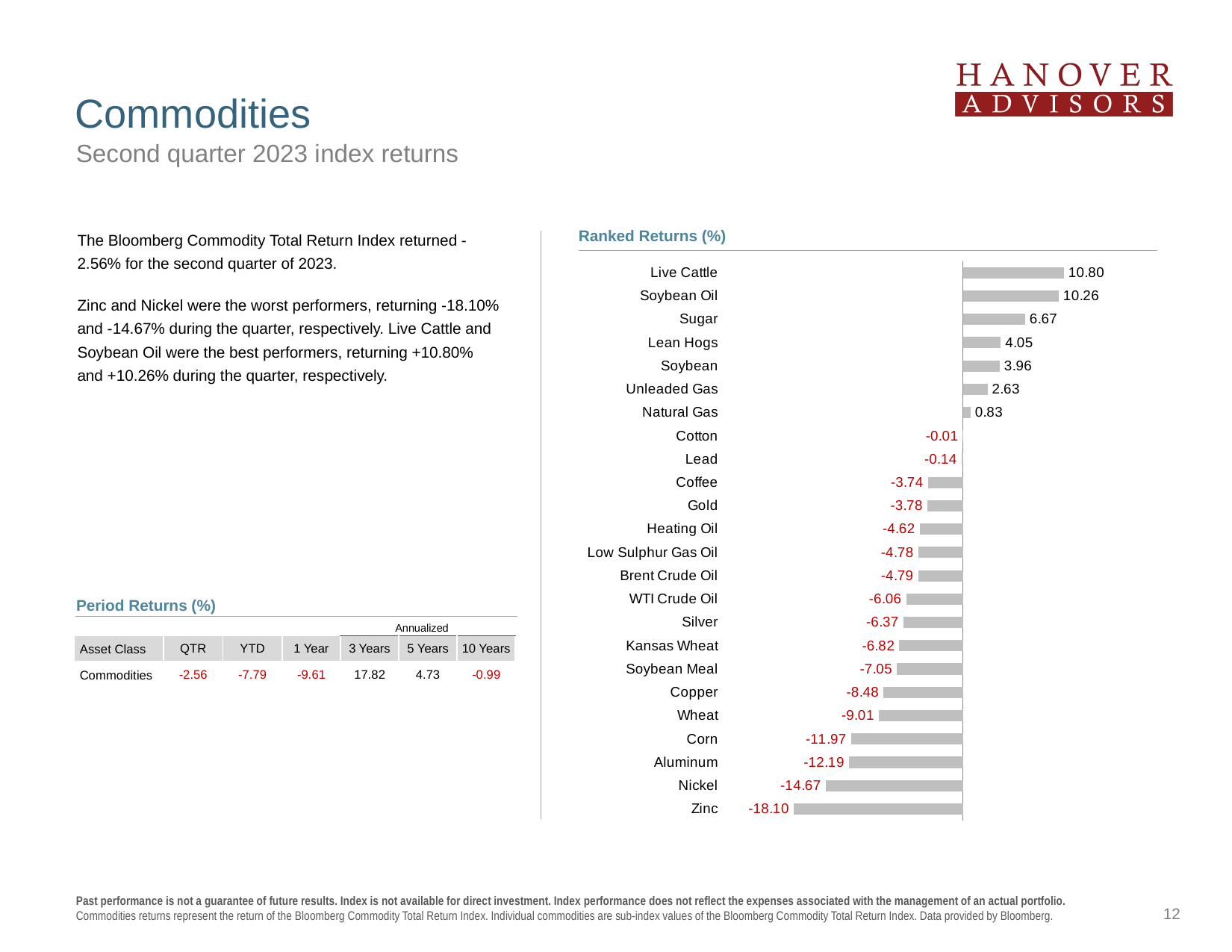
What is the value for Natural Gas in the Ranked Returns (%) chart? 0.83 What kind of chart is the Ranked Returns (%) chart? Bar chart What is the difference between the values for Live Cattle and Soybean Oil in the Ranked Returns (%) chart? 0.54 What is the value for Zinc in the Ranked Returns (%) chart? -18.10 What is the difference between the values for Nickel and Zinc in the Ranked Returns (%) chart? 3.43 How many commodities are shown in the Ranked Returns (%) chart? 24 What is the value for Live Cattle in the Ranked Returns (%) chart? 10.80 Which commodity has the highest value in the Ranked Returns (%) chart? Live Cattle What is the value for Copper in the Ranked Returns (%) chart? -8.48 Which has a larger value in the Ranked Returns (%) chart, Corn or Wheat? Wheat Which has a larger value in the Ranked Returns (%) chart, Sugar or Lean Hogs? Sugar Which commodity has the lowest value in the Ranked Returns (%) chart? Zinc